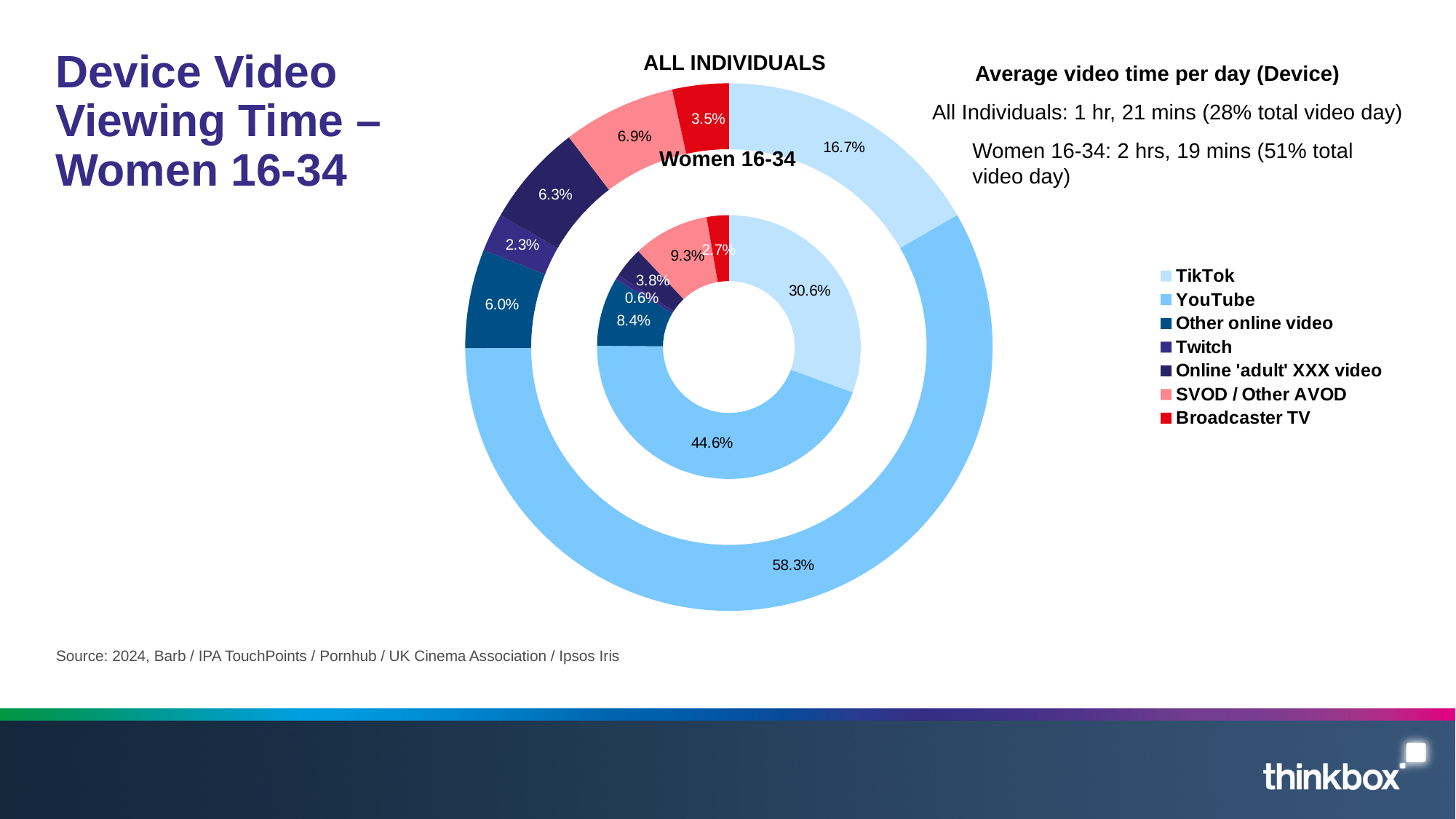
Which is larger in the All Individuals ring: Broadcaster TV or Online 'adult' XXX video? Online 'adult' XXX video How many categories does the legend list? 7 According to the text on the slide, what is the average device video time per day for Women 16-34? 2 hrs, 19 mins In the outer ring (All Individuals), what share is SVOD / Other AVOD? 6.9% Which category has the smallest share in the All Individuals ring? Twitch In the inner ring (Women 16-34), what share of device video time is TikTok? 30.6% In the inner ring (Women 16-34), what share is Twitch? 0.6% In the outer ring (All Individuals), what share of device video time is YouTube? 58.3% Which is larger for Women 16-34: the share for Other online video or the share for SVOD / Other AVOD? SVOD / Other AVOD Which category has the largest share in the Women 16-34 ring? YouTube What is the difference between the TikTok share for Women 16-34 and for All Individuals? 13.9 percentage points What kind of chart is shown on the slide? Doughnut chart